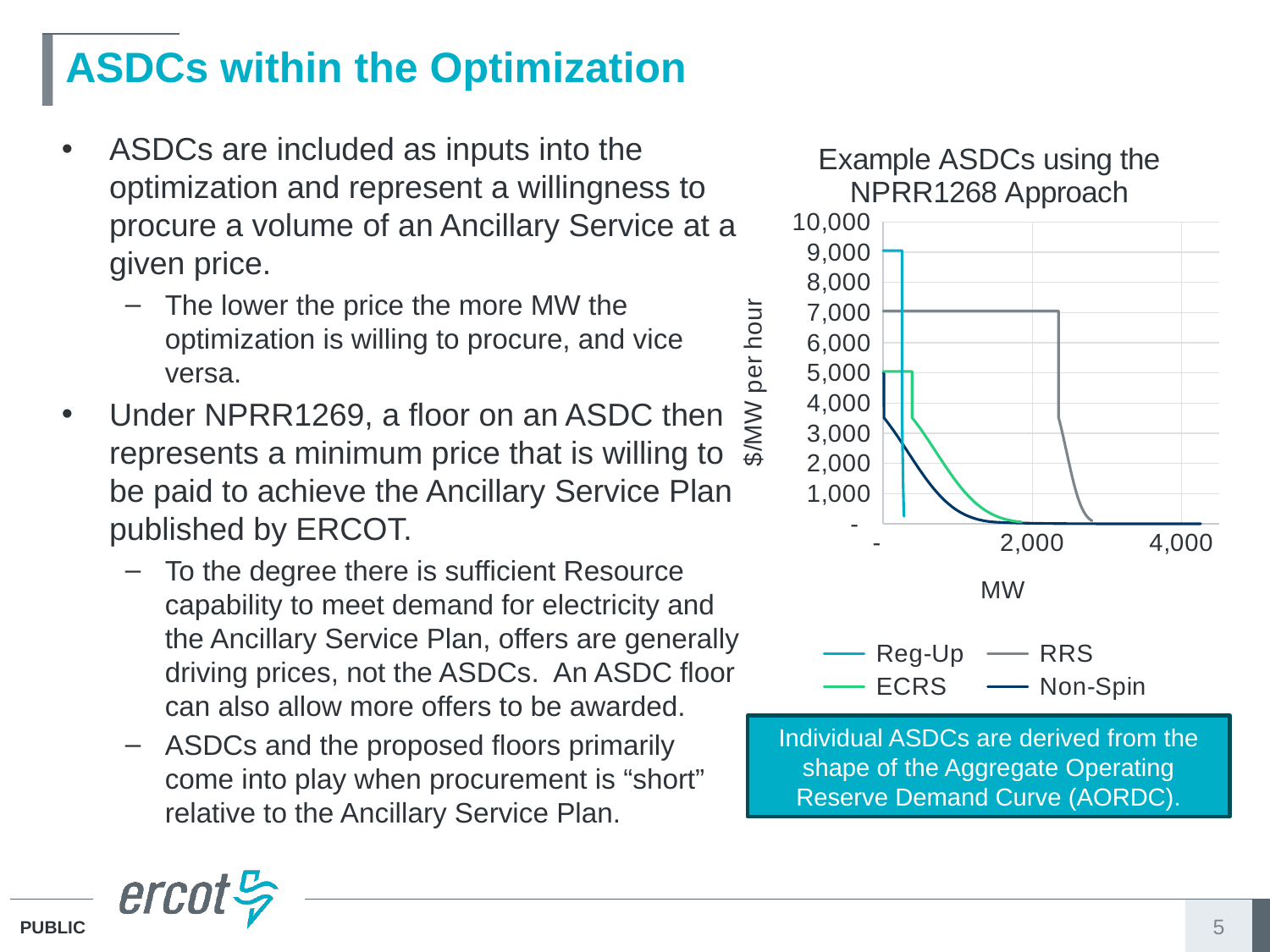
Do the curves rise or fall as MW increases along the x axis? fall Is the flat portion of the RRS curve greater or less than 6,000? greater Which has a higher flat price level, RRS or ECRS? RRS Is the starting price of the ECRS curve greater or less than 6,000? less How many series does the chart legend list? 4 What is the label on the vertical axis of the chart? $/MW per hour Which series reaches the highest price on the chart? Reg-Up What is the title of the chart? Example ASDCs using the NPRR1268 Approach What kind of chart is shown on the slide? line chart Which series extends furthest along the MW axis before reaching zero? RRS Which series drops to zero at the smallest MW quantity? Reg-Up Is the starting price of the Reg-Up curve greater or less than 8,000? greater